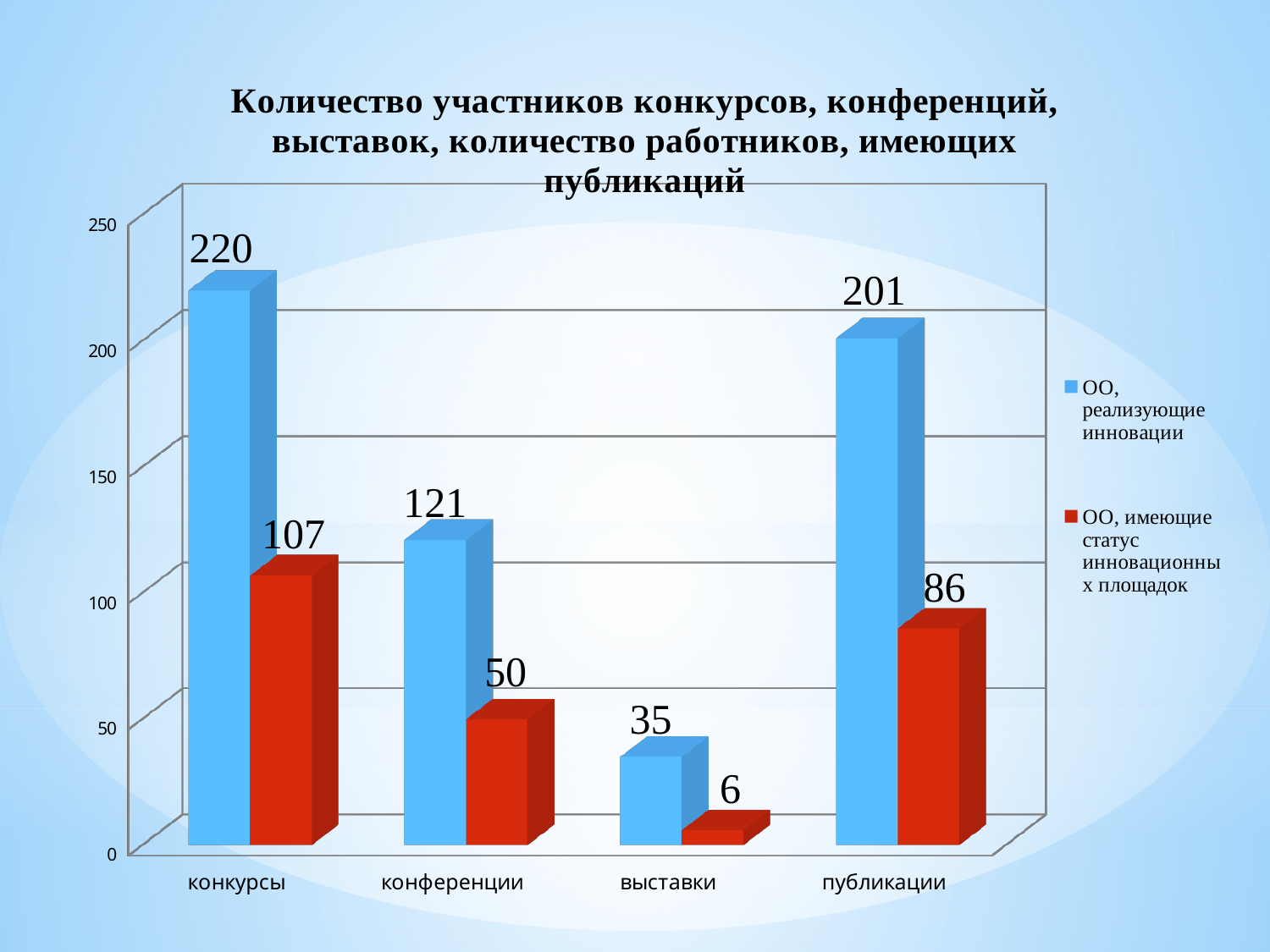
What kind of chart is shown on the slide? bar chart Which category has the lowest value in the series ОО, имеющие статус инновационных площадок? выставки What is the value for конкурсы in the series ОО, реализующие инновации? 220 Which is larger: the value for публикации in ОО, реализующие инновации or the value for конкурсы in ОО, реализующие инновации? конкурсы What colour are the bars for the series ОО, имеющие статус инновационных площадок? red Is the value for конкурсы in the series ОО, имеющие статус инновационных площадок greater or less than 100? greater How many series does the legend list? 2 What is the value for публикации in the series ОО, имеющие статус инновационных площадок? 86 What is the difference between the two series for конференции? 71 How many categories are shown on the x axis? 4 Which category has the highest value in the series ОО, реализующие инновации? конкурсы What is the value for выставки in the series ОО, реализующие инновации? 35